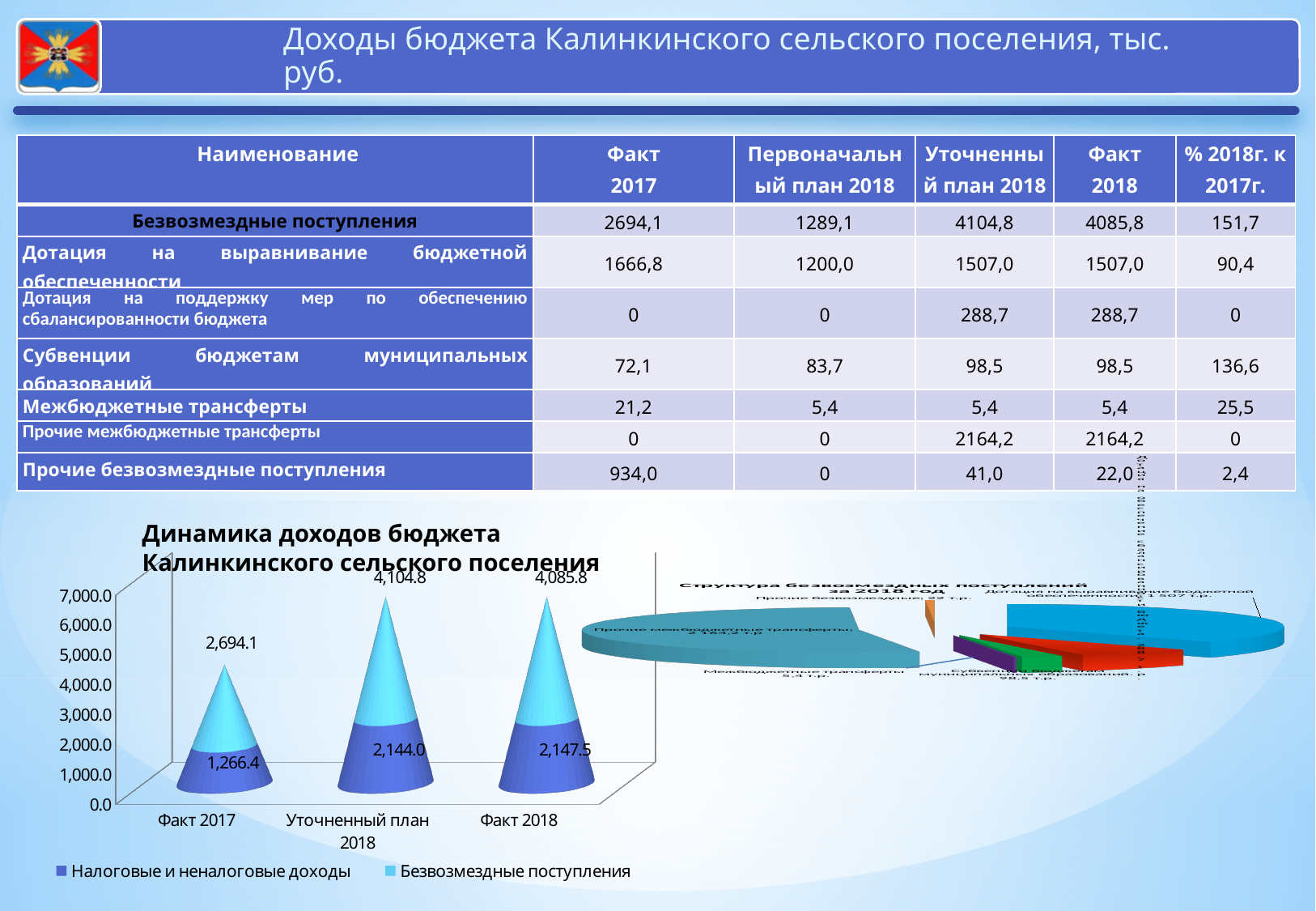
In the chart 'Динамика доходов бюджета Калинкинского сельского поселения', what is the total of the stacked bar for Факт 2017? 3,960.5 In the chart 'Динамика доходов бюджета Калинкинского сельского поселения', what is the difference between Безвозмездные поступления for Факт 2018 and for Факт 2017? 1,391.7 In the chart 'Динамика доходов бюджета Калинкинского сельского поселения', what is the value of Налоговые и неналоговые доходы for Факт 2017? 1,266.4 In the chart 'Динамика доходов бюджета Калинкинского сельского поселения', which category has the lowest value for Налоговые и неналоговые доходы? Факт 2017 In the chart 'Динамика доходов бюджета Калинкинского сельского поселения', which is larger for Налоговые и неналоговые доходы: Факт 2018 or Уточненный план 2018? Факт 2018 In the chart 'Динамика доходов бюджета Калинкинского сельского поселения', which category has the highest value for Безвозмездные поступления? Уточненный план 2018 In the chart 'Динамика доходов бюджета Калинкинского сельского поселения', what is the value of Безвозмездные поступления for Уточненный план 2018? 4,104.8 In the chart 'Динамика доходов бюджета Калинкинского сельского поселения', what is the value of Безвозмездные поступления for Факт 2018? 4,085.8 In the chart 'Динамика доходов бюджета Калинкинского сельского поселения', how many series does the legend list? 2 In the chart 'Динамика доходов бюджета Калинкинского сельского поселения', how many categories are shown on the x axis? 3 What is the title of the pie chart on the right side of the slide? Структура безвозмездных поступлений за 2018 год In the chart 'Динамика доходов бюджета Калинкинского сельского поселения', what kind of chart is it? bar chart